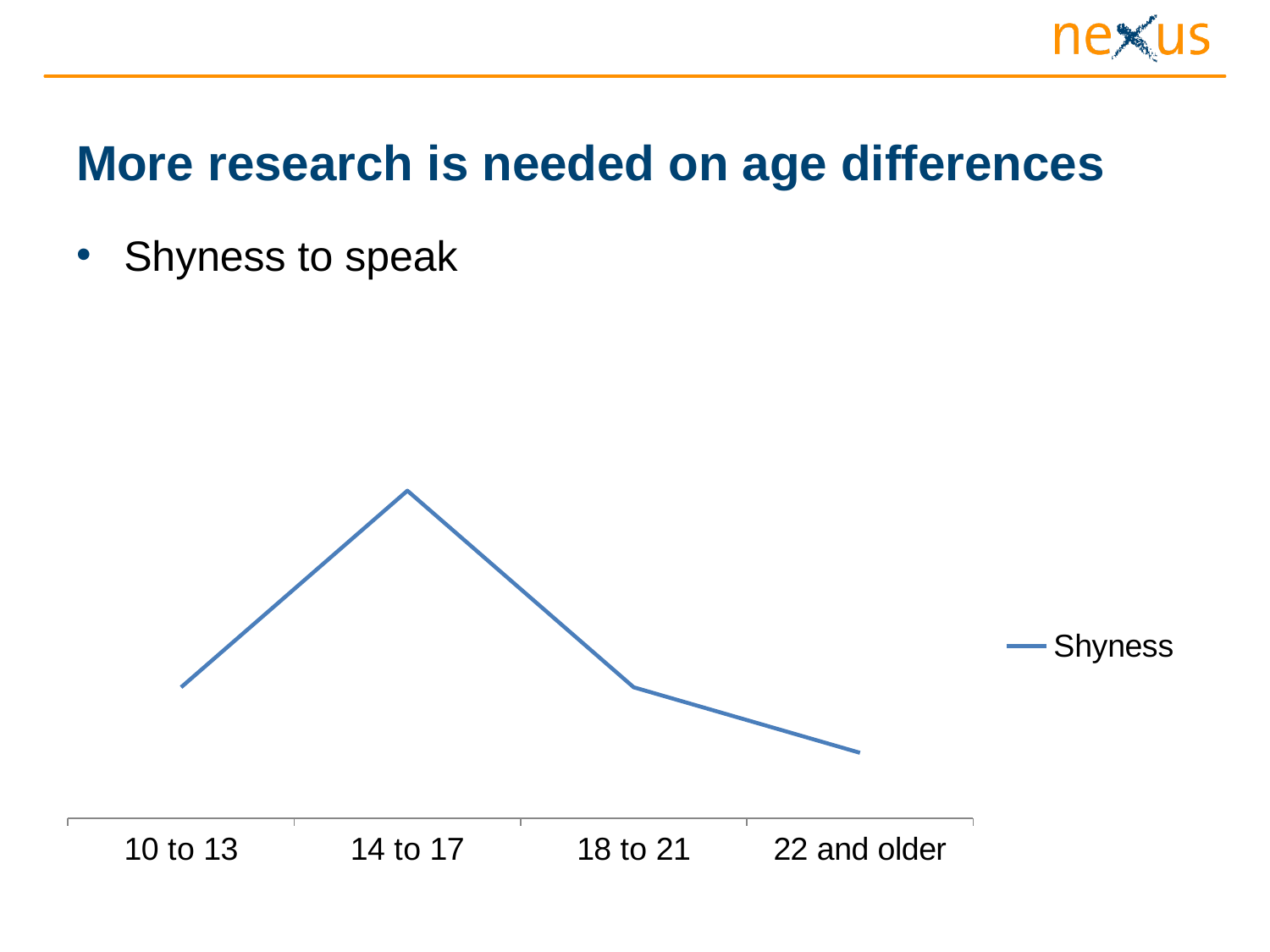
Does the Shyness value rise or fall from 14 to 17 through to 22 and older? fall Which age category has the lowest Shyness value? 22 and older How many series does the chart's legend list? 1 How many age categories are shown on the x axis of the chart? 4 What is the first age category on the x axis of the chart? 10 to 13 What kind of chart is shown on the slide? line chart Which has the higher Shyness value, 10 to 13 or 22 and older? 10 to 13 Which age category has the highest Shyness value? 14 to 17 Which has the higher Shyness value, 14 to 17 or 18 to 21? 14 to 17 Does the Shyness value rise or fall from 10 to 13 to 14 to 17? rise What is the name of the series shown in the chart's legend? Shyness Which has the higher Shyness value, 18 to 21 or 22 and older? 18 to 21